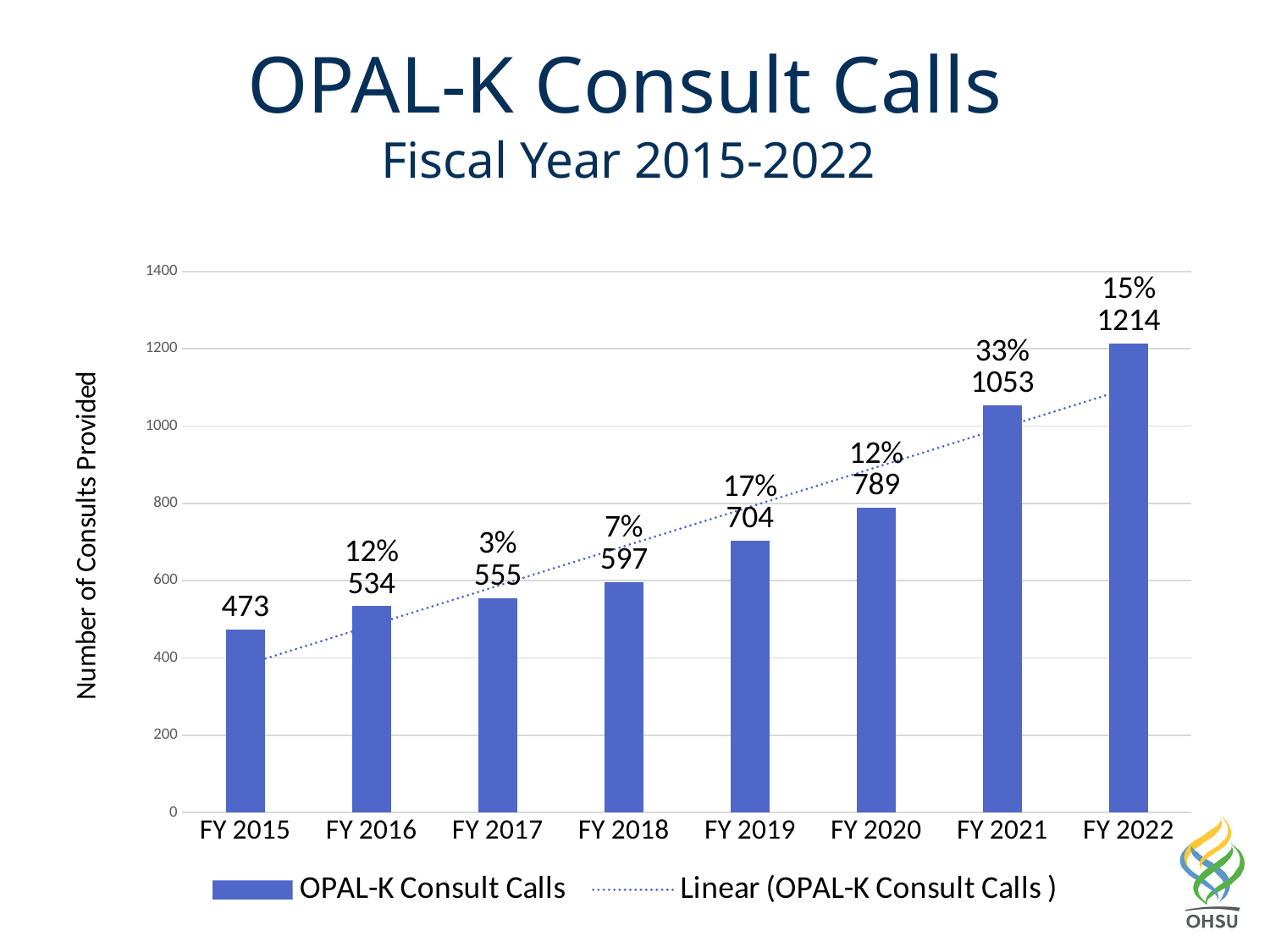
Is the value for FY 2017 greater or less than 600? less What kind of chart is shown on the slide? bar chart How many OPAL-K consult calls were provided in FY 2019? 704 Which fiscal year has the highest number of consults provided? FY 2022 How many fiscal years are shown on the x axis? 8 What percentage growth is labelled above the FY 2021 bar? 33% Which fiscal year has the lowest number of consults provided? FY 2015 Which is larger, the value for FY 2018 or the value for FY 2020? FY 2020 Do the consult call values rise or fall from FY 2015 to FY 2022? rise What is the value for FY 2015? 473 What is the difference in consult calls between FY 2022 and FY 2021? 161 How many entries does the legend list? 2